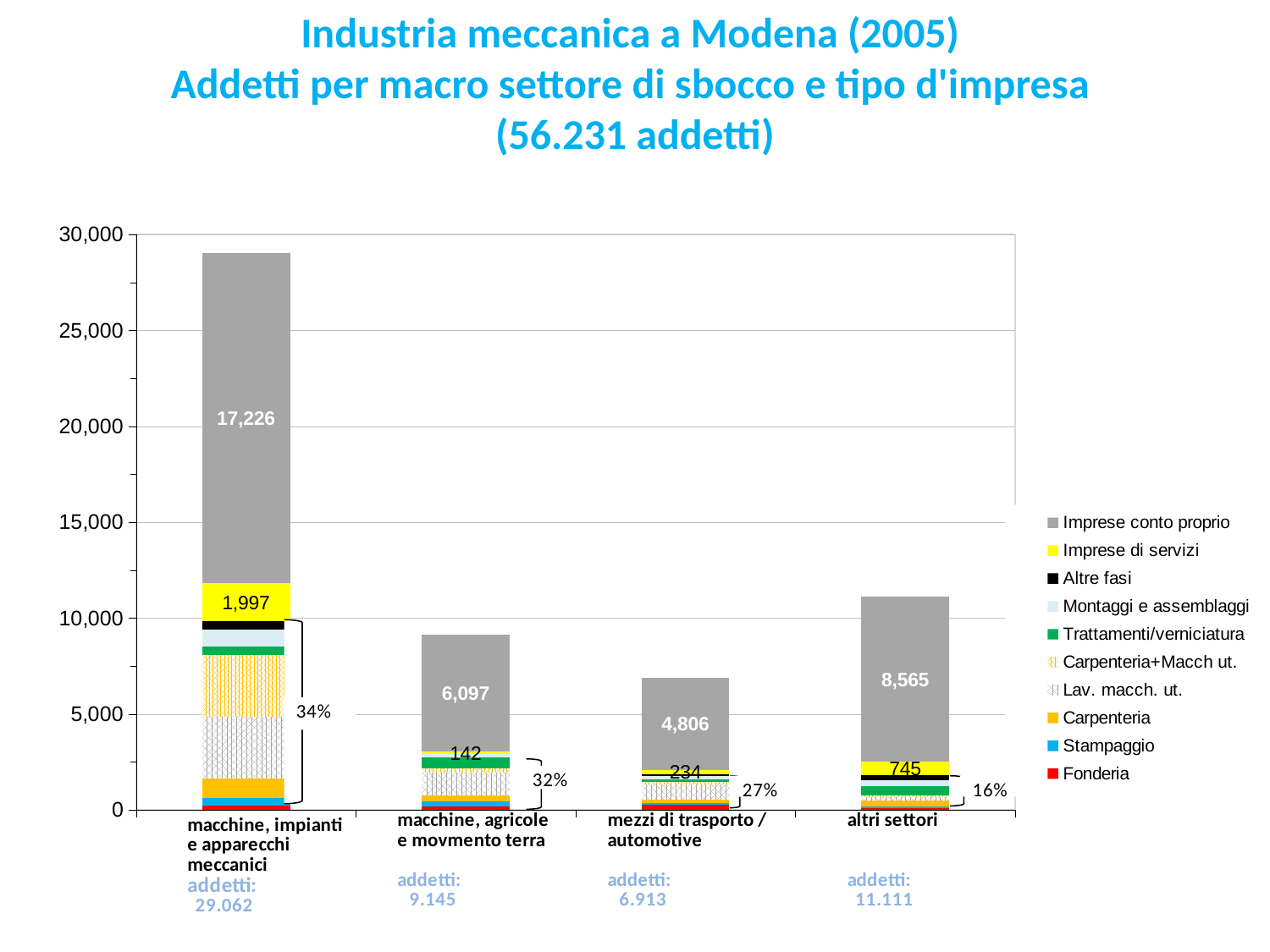
Is the total height of the 'altri settori' bar greater or less than 10,000? greater What total number of addetti is printed under 'macchine, agricole e movimento terra'? 9.145 What percentage is annotated next to the 'altri settori' bar? 16% What is the value of Imprese conto proprio for 'macchine, impianti e apparecchi meccanici'? 17,226 What is the difference between the Imprese conto proprio values for 'macchine, impianti e apparecchi meccanici' and 'altri settori'? 8,661 What kind of chart is shown on the slide? stacked bar chart What is the value of Imprese di servizi for 'altri settori'? 745 Which category has the highest value for Imprese conto proprio? macchine, impianti e apparecchi meccanici Which category has the lowest value for Imprese conto proprio? mezzi di trasporto / automotive How many series does the legend list? 10 How many categories (macro settori) are shown on the x axis? 4 Which has the larger Imprese di servizi value: 'macchine, agricole e movimento terra' or 'mezzi di trasporto / automotive'? mezzi di trasporto / automotive